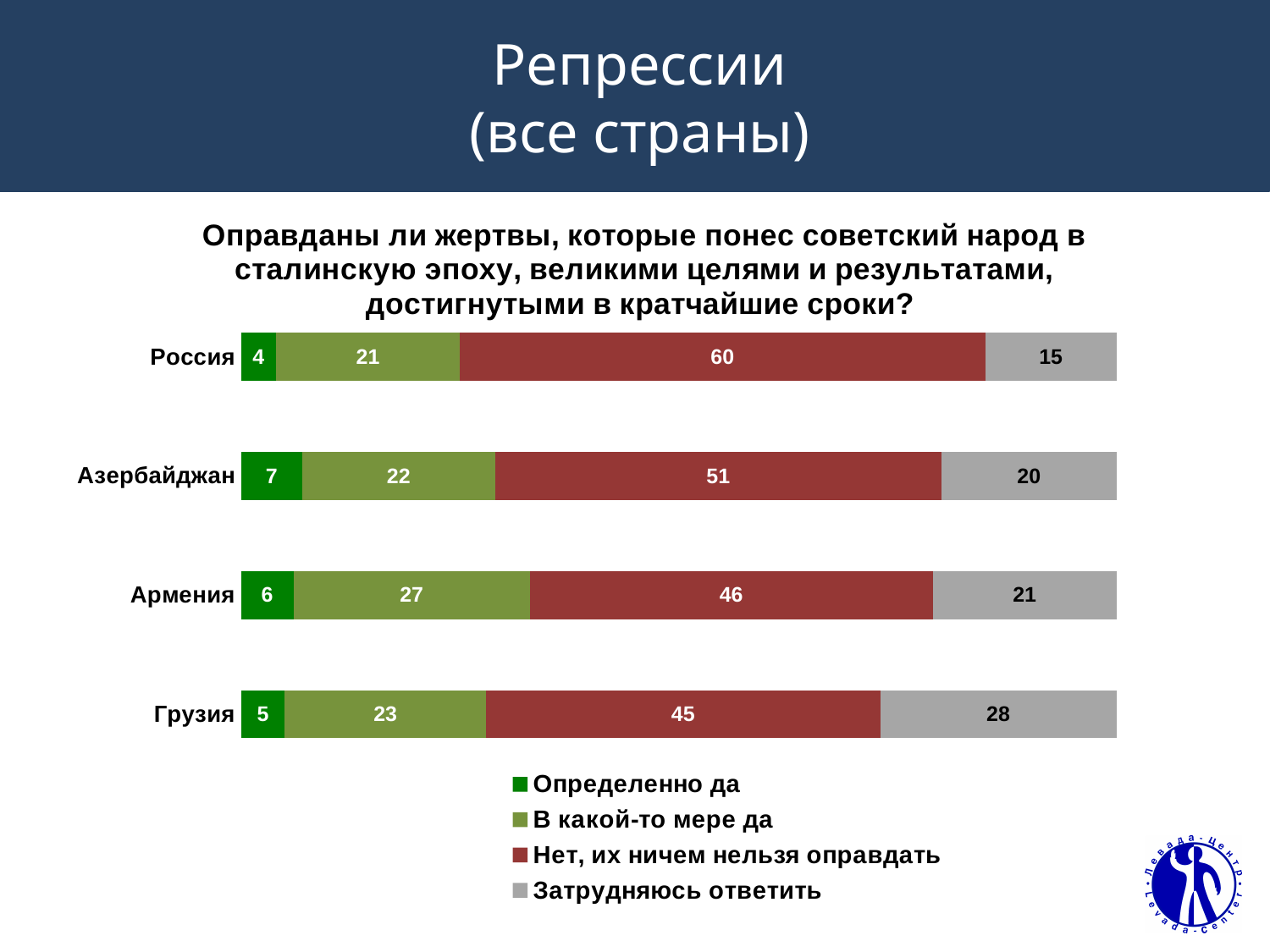
Which country has the highest value for "Нет, их ничем нельзя оправдать"? Россия How many series does the legend list? 4 What is the value for "Затрудняюсь ответить" for Грузия? 28 Which country has the lowest value for "Затрудняюсь ответить"? Россия What is the total of the stacked bar for Армения? 100 What kind of chart is shown on the slide? Stacked bar chart What is the difference between the "Нет, их ничем нельзя оправдать" values for Россия and Грузия? 15 What is the value for "Определенно да" for Азербайджан? 7 What is the value for "Нет, их ничем нельзя оправдать" for Россия? 60 Which is larger: the "В какой-то мере да" value for Армения or for Азербайджан? Армения How many countries are shown in the chart? 4 What is the value for "В какой-то мере да" for Армения? 27